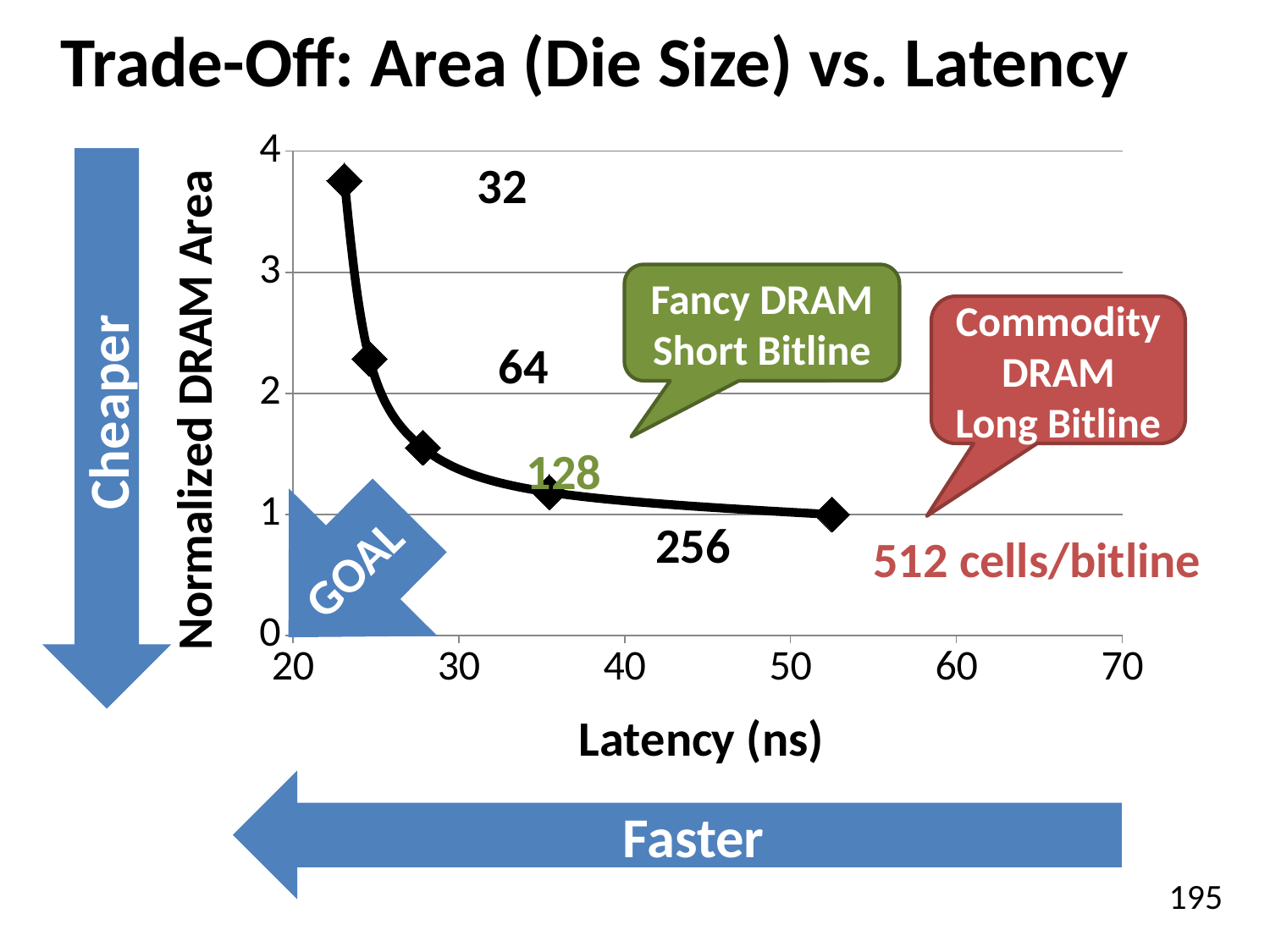
Is the normalized DRAM area for the 32 cells/bitline point greater or less than 3? greater Which cells/bitline value is labeled as Commodity DRAM Long Bitline? 512 cells/bitline Which labeled configuration has the lowest normalized DRAM area? 512 cells/bitline Which has a larger normalized DRAM area, the 32 point or the 64 point? 32 What is the normalized DRAM area for the 512 cells/bitline point? 1 As latency increases along the x axis, does the normalized DRAM area rise or fall? fall How many data points are plotted on the curve? 5 What is the title of the x axis? Latency (ns) Which labeled configuration has the highest normalized DRAM area? 32 What kind of chart is shown on the slide? line chart Is the latency of the 512 cells/bitline point greater or less than 50 ns? greater Is the normalized DRAM area for the 64 cells/bitline point greater or less than 2? greater